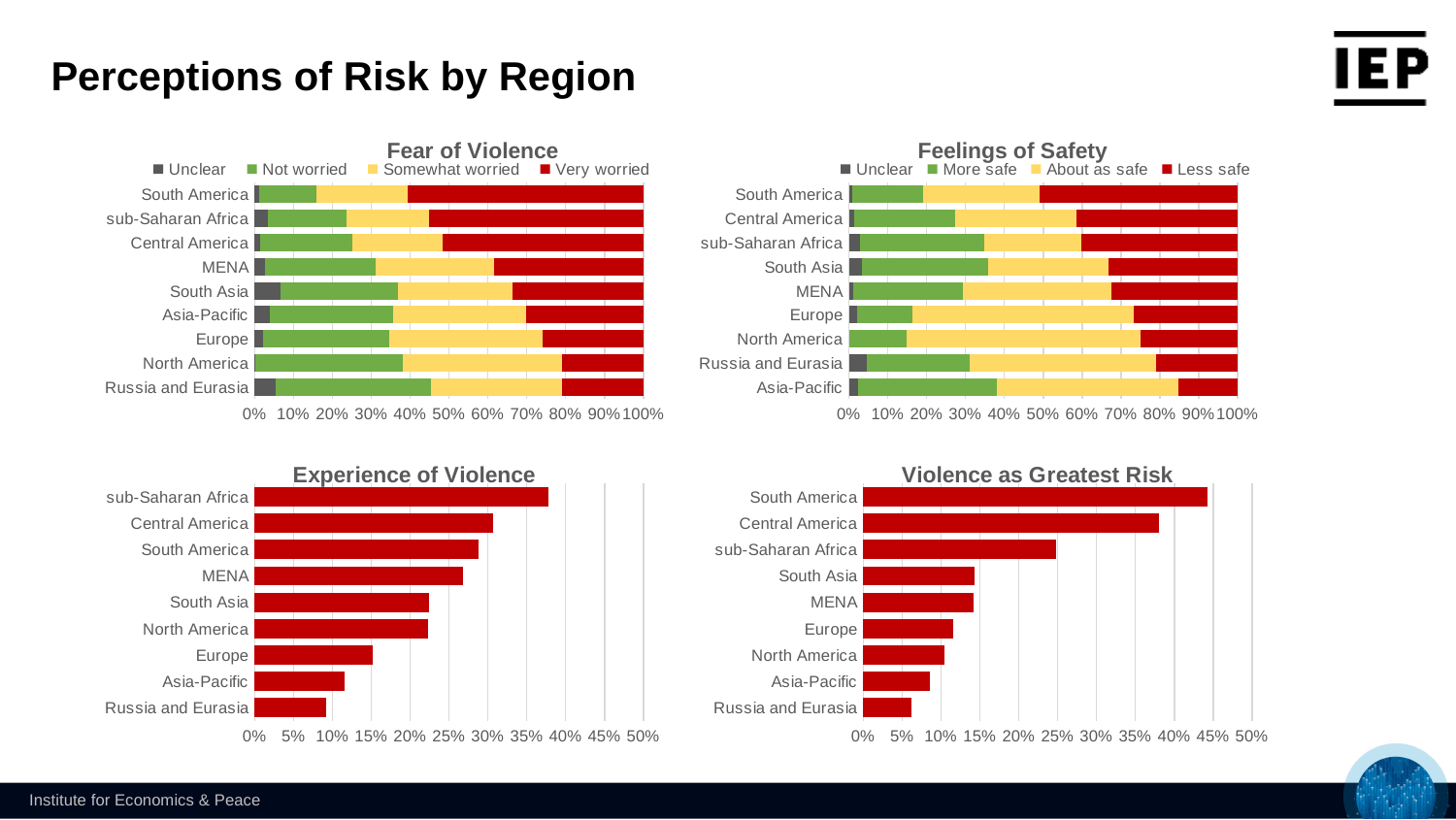
In the Experience of Violence chart, which is larger, the value for Europe or the value for Asia-Pacific? Europe In the Experience of Violence chart, which region has the highest value? sub-Saharan Africa How many regions are shown in the Feelings of Safety chart? 9 In the Experience of Violence chart, which region has the lowest value? Russia and Eurasia In the Violence as Greatest Risk chart, is the value for South America greater or less than 40%? greater What kind of chart is the Violence as Greatest Risk chart? Bar chart In the Feelings of Safety chart, which region has the largest 'Less safe' segment? South America How many series does the legend of the Fear of Violence chart list? 4 In the Violence as Greatest Risk chart, which region has the highest value? South America In the Violence as Greatest Risk chart, which region has the lowest value? Russia and Eurasia In the Experience of Violence chart, is the value for sub-Saharan Africa greater or less than 35%? greater In the Violence as Greatest Risk chart, is the value for Russia and Eurasia greater or less than 10%? less